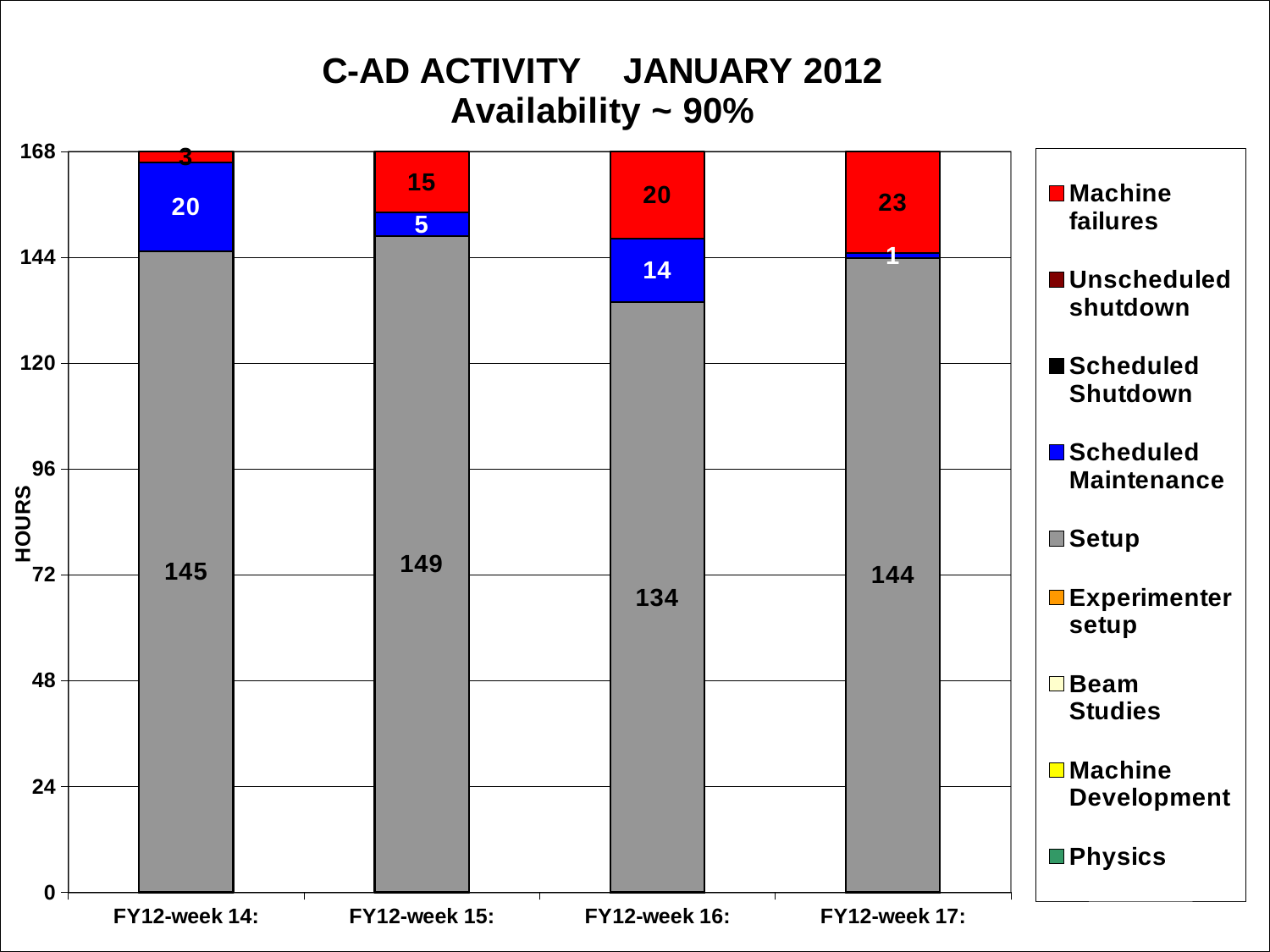
Which week has the highest number of Setup hours? FY12-week 15: How many series does the legend list? 9 How many hours of Setup are shown for FY12-week 15? 149 What type of chart is shown on the slide? stacked bar chart What is the total of the stacked bar for FY12-week 16? 168 How many hours of Scheduled Maintenance are shown for FY12-week 16? 14 Which is larger, the Scheduled Maintenance hours in FY12-week 14 or in FY12-week 15? FY12-week 14: Which week has the lowest number of Machine failures hours? FY12-week 14: What is the difference in Setup hours between FY12-week 15 and FY12-week 16? 15 How many weeks (categories) are shown on the x axis? 4 How many hours of Machine failures are shown for FY12-week 17? 23 What is the label of the vertical axis? HOURS